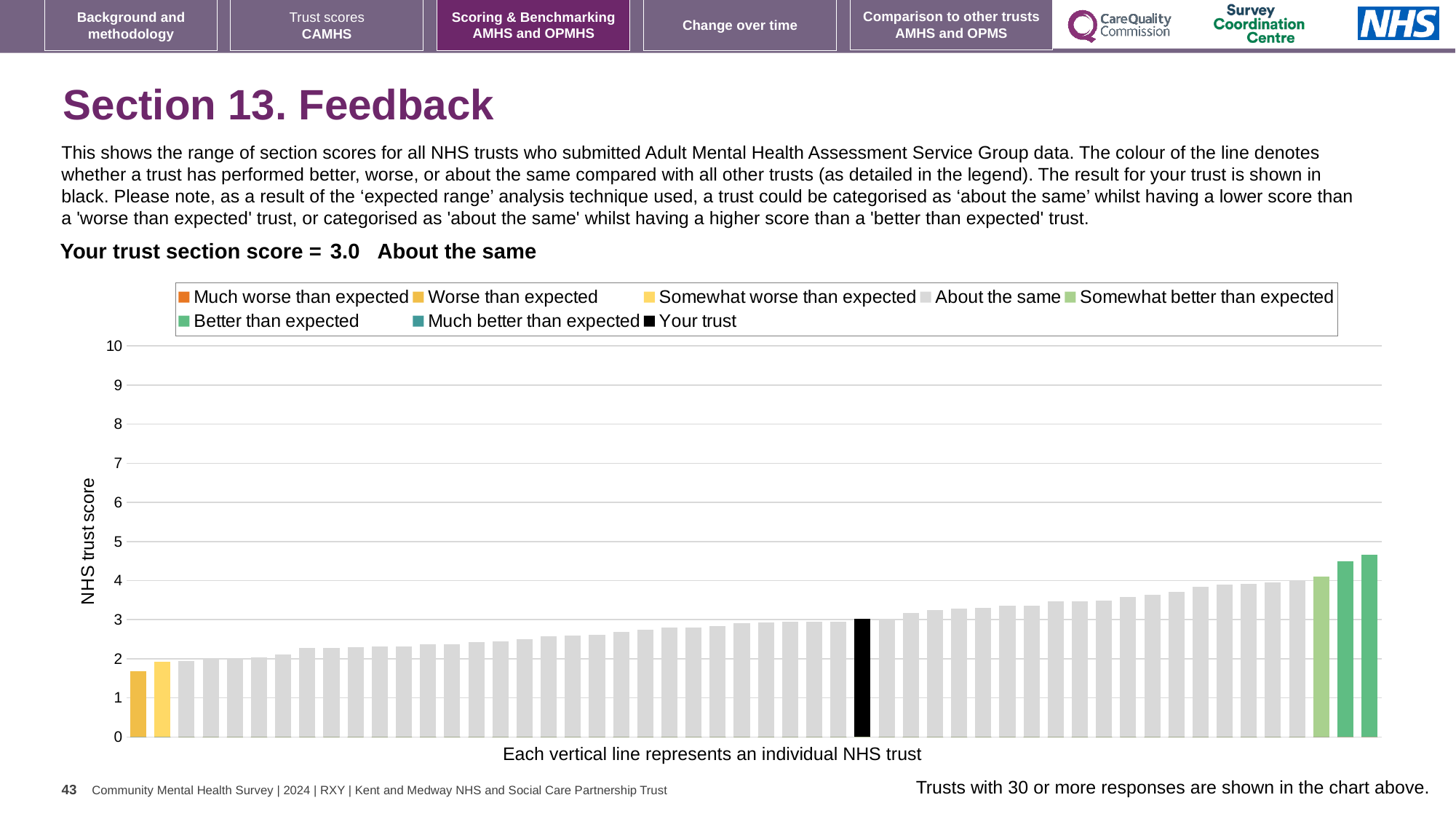
What colour is used for the 'Your trust' bar in the chart? black What is the section score for your trust shown on the slide? 3.0 How many bars are shown in the 'Better than expected' colour? 2 Is the value of the rightmost bar greater or less than 4? greater What kind of chart is shown on the slide? bar chart Do the bar values rise or fall from left to right across the chart? rise Which category is your trust placed in for this section? About the same Is the value of the leftmost bar greater or less than 2? less What is the label on the vertical axis of the chart? NHS trust score Is the value of the black 'Your trust' bar greater or less than 4? less How many entries does the chart legend list? 8 Which is larger, the leftmost bar or the rightmost bar? the rightmost bar